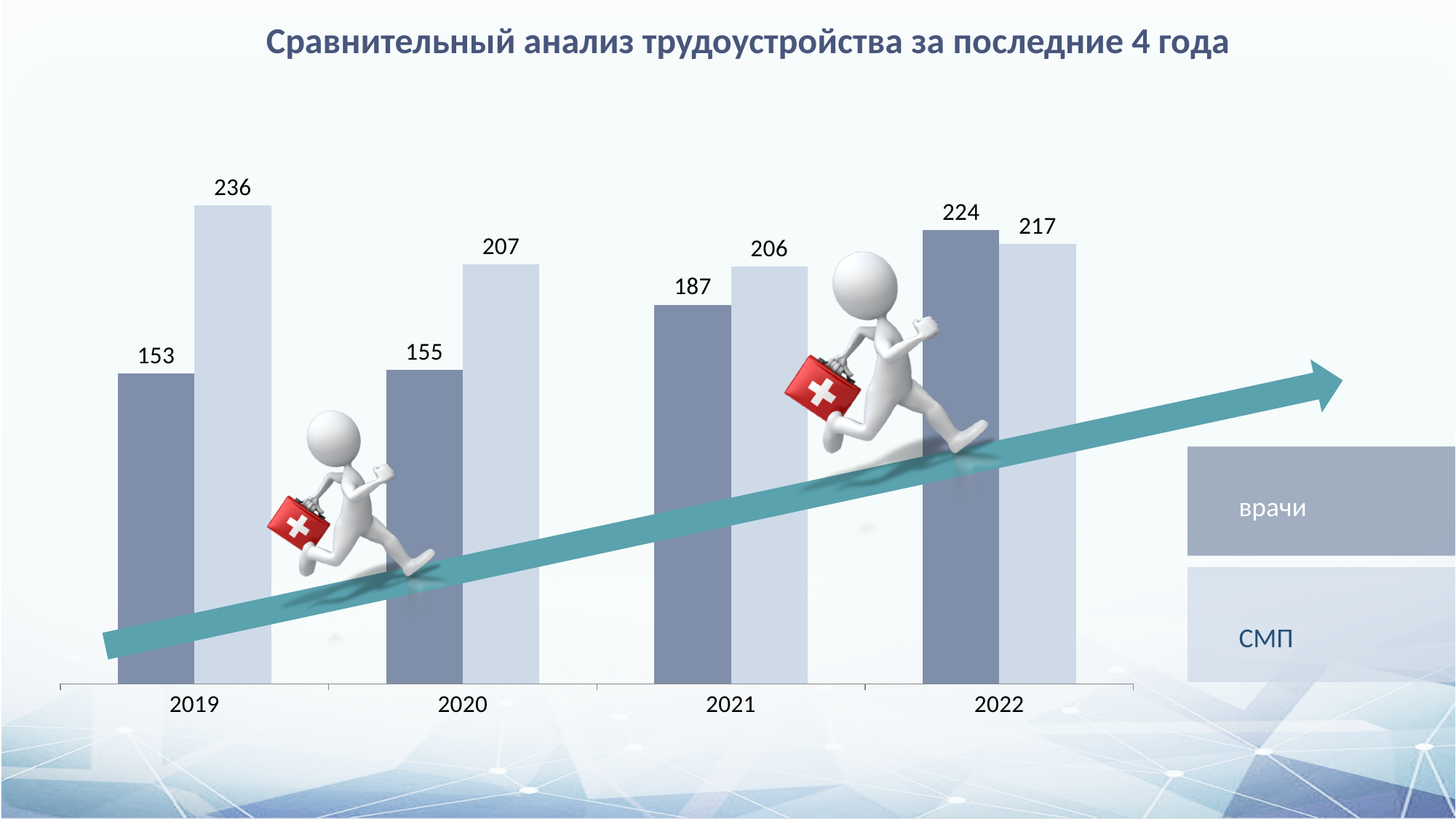
What is the value for врачи in 2022? 224 How many years are shown on the x axis? 4 What kind of chart is shown on the slide? bar chart What is the value for врачи in 2019? 153 In which year is the value for СМП highest? 2019 How many series does the legend list? 2 In 2022, which series has the larger value, врачи or СМП? врачи Do the values for врачи rise or fall from 2019 to 2022? rise What is the value for СМП in 2020? 207 In which year is the value for врачи lowest? 2019 What is the difference between the врачи values in 2022 and 2021? 37 What is the difference between the СМП and врачи values in 2019? 83